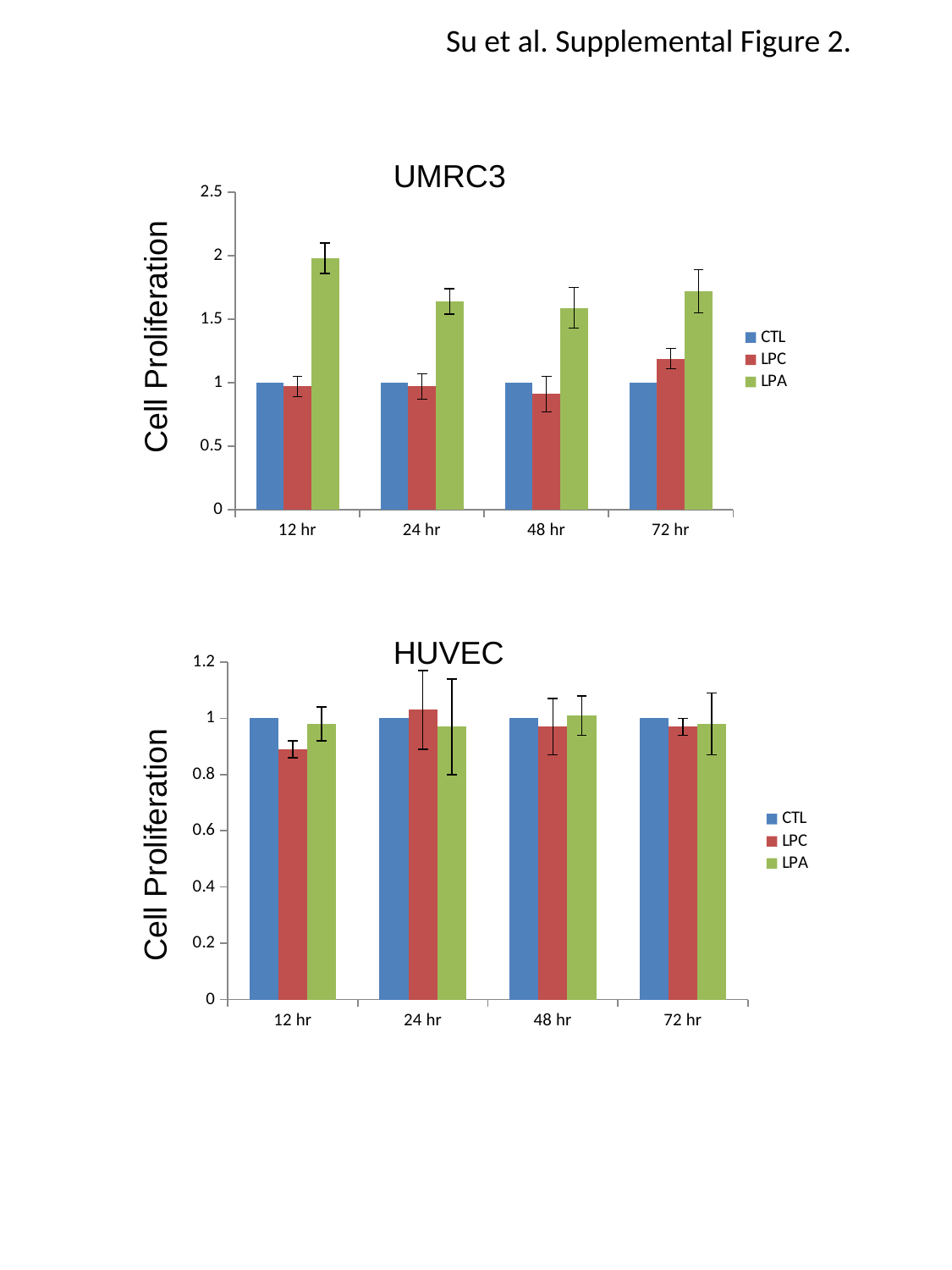
What kind of chart is the UMRC3 chart? bar chart How many series does the legend of the UMRC3 chart list? 3 What is the y-axis title of the HUVEC chart? Cell Proliferation In the UMRC3 chart, which series has the highest value at 12 hr? LPA In the UMRC3 chart, what is the value for CTL at 12 hr? 1 In the UMRC3 chart, which is larger: the LPA value at 12 hr or the LPA value at 24 hr? 12 hr In the HUVEC chart, what is the value for CTL at 24 hr? 1 In the UMRC3 chart, is the value for LPC at 72 hr greater or less than 1? greater How many time-point categories are shown on the x axis of the UMRC3 chart? 4 In the HUVEC chart, is the value for LPC at 12 hr greater or less than 1? less What kind of chart is the HUVEC chart? bar chart In the UMRC3 chart, is the value for LPA at 12 hr greater or less than 1.5? greater